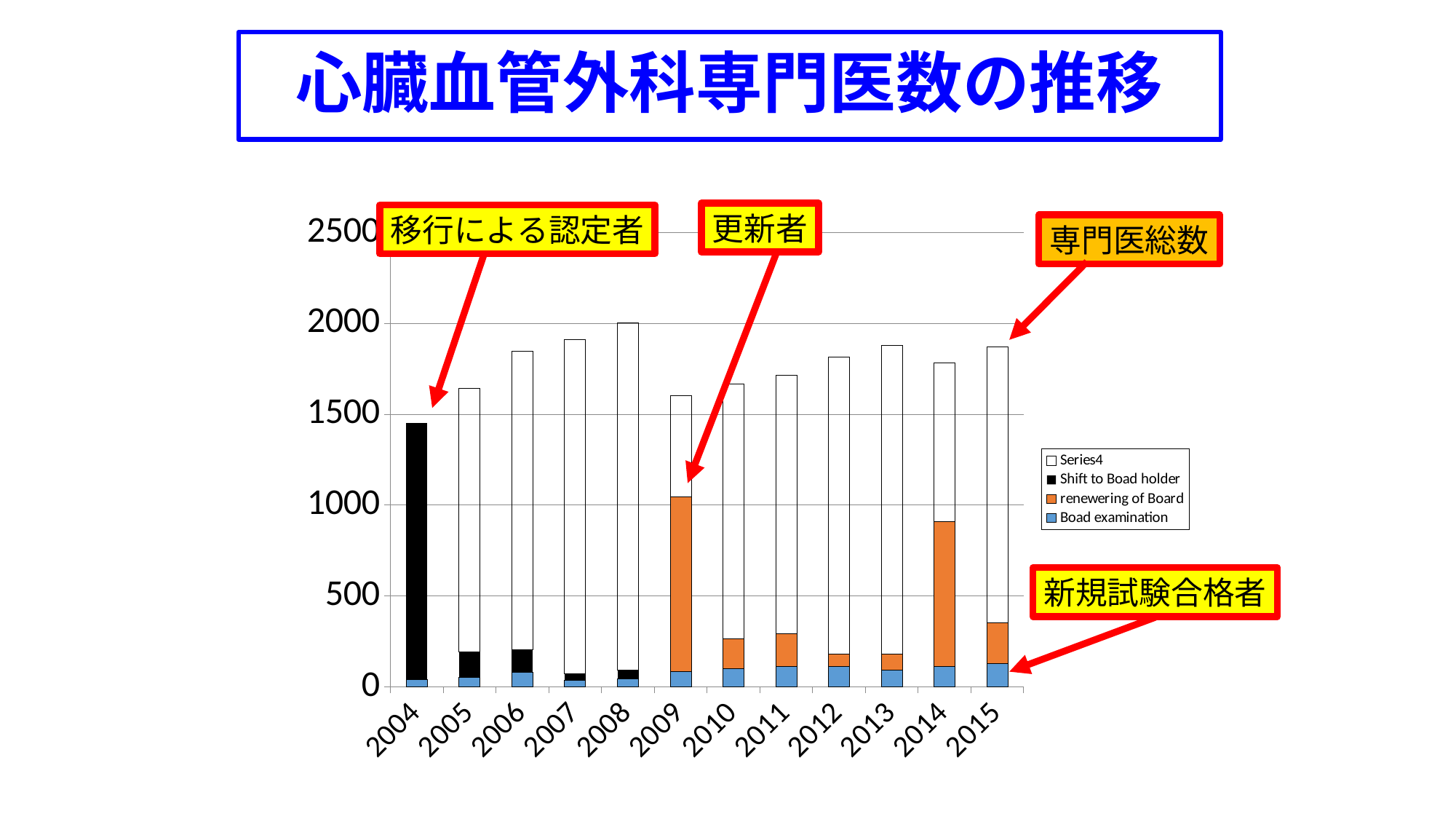
Is the total bar for 2004 greater or less than 1500? less Which year has the shortest total bar? 2004 What kind of chart is shown on the slide? bar chart Is the total bar for 2008 larger than the total bar for 2009? yes Is the total bar for 2015 greater or less than 2000? less Do the total bars rise or fall from 2004 to 2008? rise Which legend entry is shown in orange? renewering of Board Which year has the tallest total bar? 2008 How many years are shown on the x axis of the chart? 12 What is the title of the slide? 心臓血管外科専門医数の推移 Is the total bar for 2006 greater or less than 1500? greater How many series does the chart legend list? 4